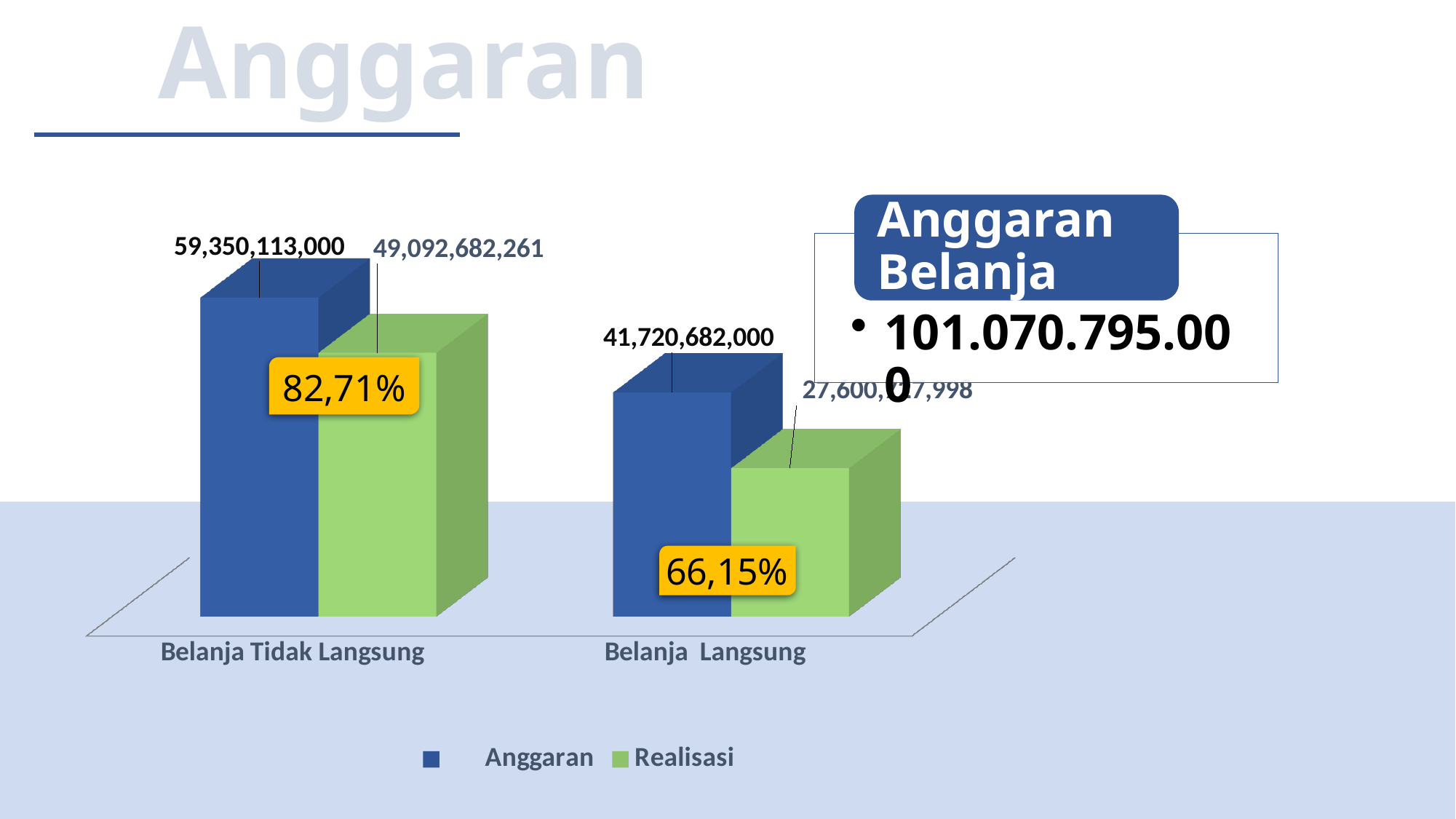
What is the Anggaran value for Belanja Tidak Langsung? 59,350,113,000 What is the difference between the Anggaran values for Belanja Tidak Langsung and Belanja Langsung? 17,629,431,000 What percentage is shown on the chart for Belanja Langsung? 66,15% Which category has the lower Realisasi value? Belanja Langsung Which category has the higher Anggaran value? Belanja Tidak Langsung What percentage is shown on the chart for Belanja Tidak Langsung? 82,71% Is the Anggaran or the Realisasi value larger for Belanja Langsung? Anggaran How many categories are shown on the x axis of the chart? 2 What is the Realisasi value for Belanja Tidak Langsung? 49,092,682,261 How many series does the chart legend list? 2 What is the Anggaran value for Belanja Langsung? 41,720,682,000 What is the difference between the Anggaran and Realisasi values for Belanja Tidak Langsung? 10,257,430,739